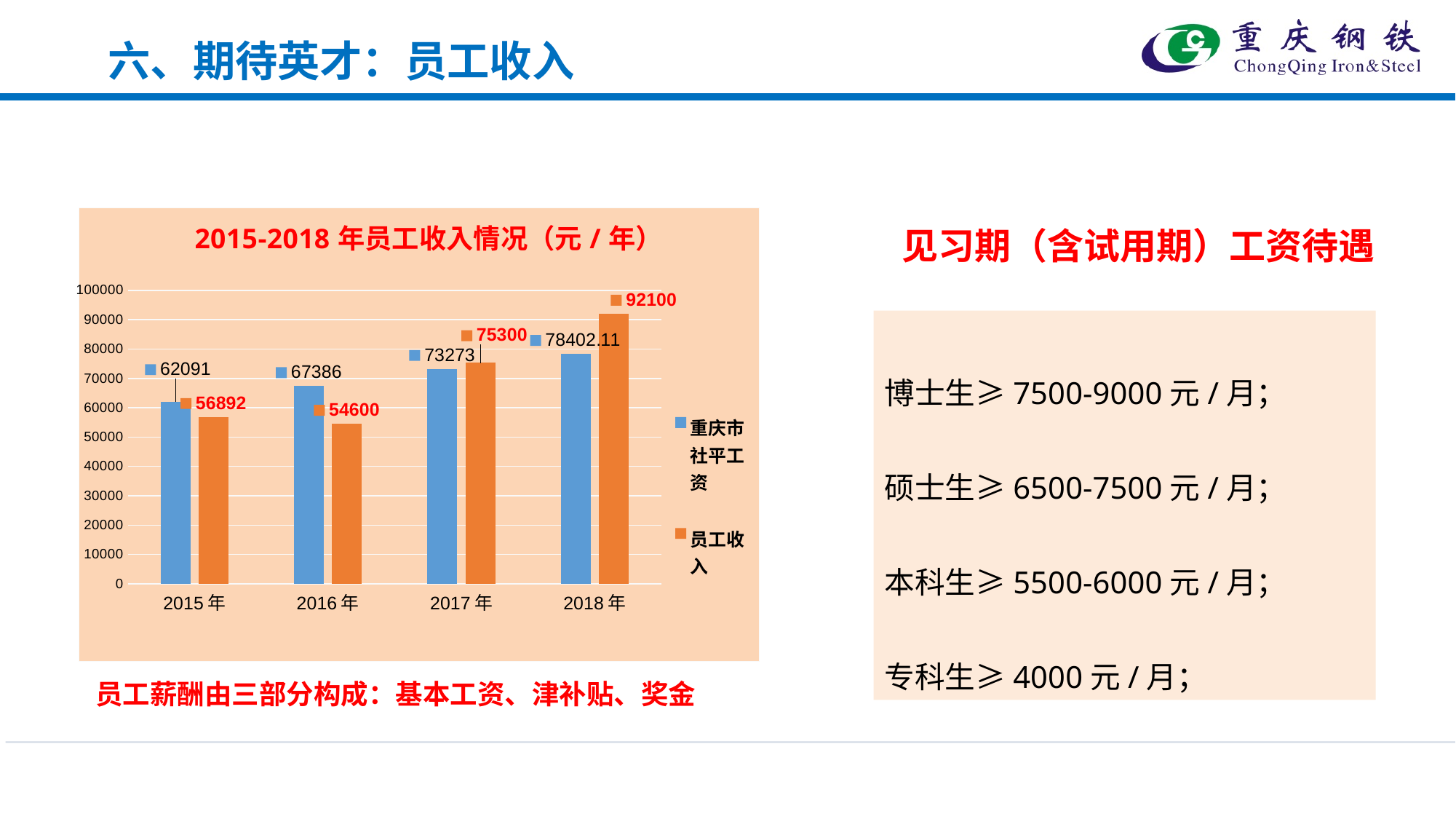
In which year is 员工收入 the highest? 2018 年 What is the 重庆市社平工资 value for 2018 年? 78402.11 In 2017 年, which is larger: 员工收入 or 重庆市社平工资? 员工收入 What is the difference between 员工收入 and 重庆市社平工资 in 2018 年? 13697.89 Does 重庆市社平工资 rise or fall from 2015 年 to 2018 年? Rise How many series does the legend list? 2 What kind of chart is shown on the slide? Bar chart What is the 员工收入 value for 2018 年? 92100 In which year is 员工收入 the lowest? 2016 年 What is the 员工收入 value for 2016 年? 54600 What is the 重庆市社平工资 value for 2015 年? 62091 In 2016 年, which is larger: 员工收入 or 重庆市社平工资? 重庆市社平工资